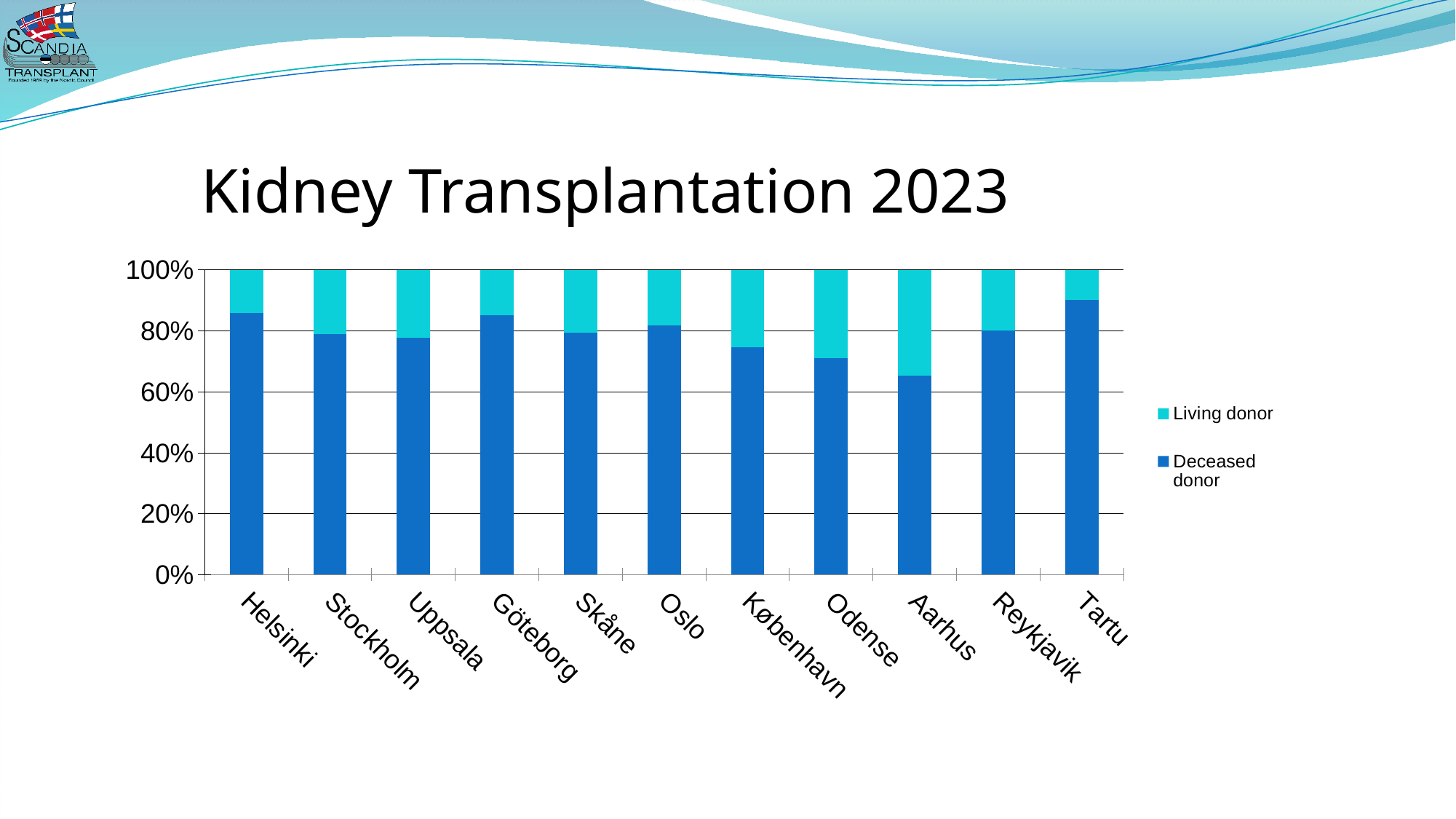
Is the deceased donor share for Aarhus greater or less than 80%? less Which centre has the highest share of deceased donor kidney transplants? Tartu Which centre has a larger deceased donor share, Helsinki or Aarhus? Helsinki Which centre has a larger living donor share, Aarhus or Tartu? Aarhus How many series does the chart legend list? 2 Which centre has the lowest share of deceased donor kidney transplants? Aarhus Is the deceased donor share for Helsinki greater or less than 80%? greater How many transplant centres are shown on the x axis of the chart? 11 What is the title of the slide containing the chart? Kidney Transplantation 2023 Is the deceased donor share for Odense greater or less than 60%? greater Which centre has the largest share of living donor kidney transplants? Aarhus What kind of chart is shown on the slide? Stacked bar chart